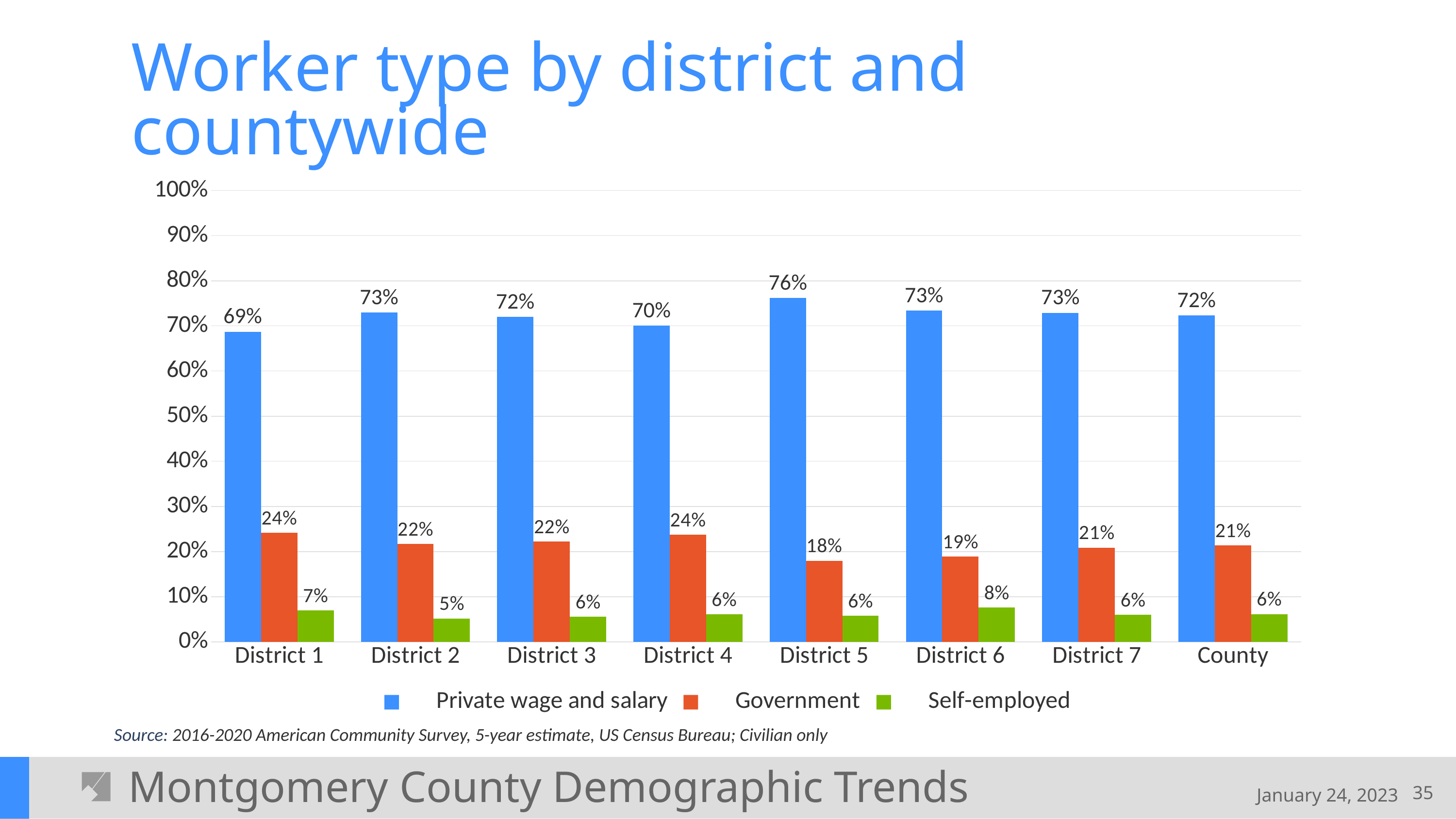
Which series is shown in green in the legend? Self-employed Which category has the lowest Self-employed value? District 2 Which is larger, the Government value for District 4 or for District 6? District 4 What is the Private wage and salary value for District 5? 76% How many categories are shown on the x axis? 8 Which category has the highest Private wage and salary value? District 5 How many series does the legend list? 3 What is the Government value for District 1? 24% What is the difference between the Government values for District 1 and District 5? 6% What kind of chart is shown on the slide? Bar chart What is the Government value for County? 21% What is the Self-employed value for District 6? 8%